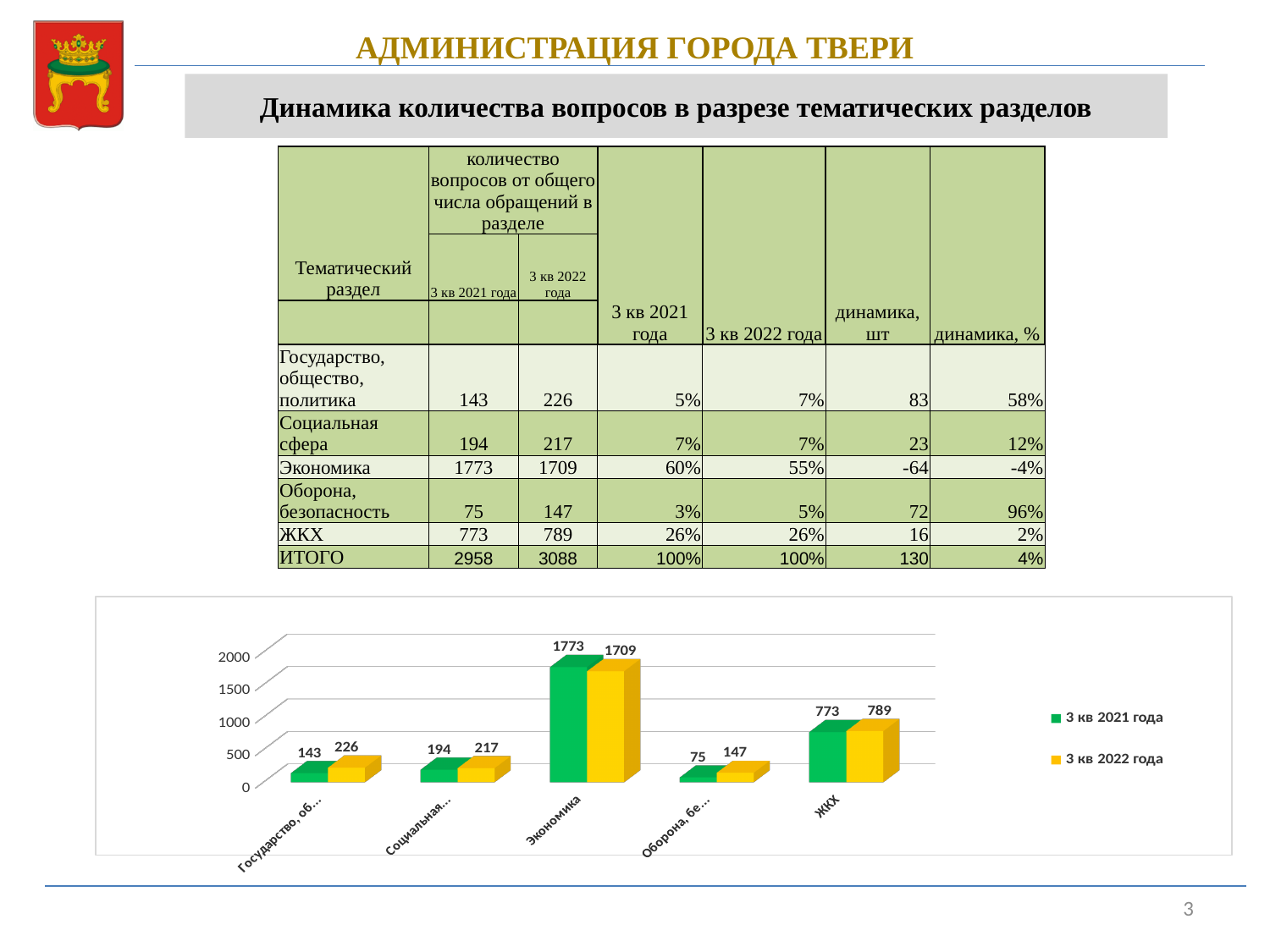
What is the value for Оборона, безопасность in the 3 кв 2021 года series? 75 For Экономика, which series has the larger value: 3 кв 2021 года or 3 кв 2022 года? 3 кв 2021 года How many series does the chart legend list? 2 Which category has the highest value in the 3 кв 2022 года series? Экономика How many categories are plotted on the chart's x axis? 5 What type of chart is shown on the slide? bar chart What is the value for ЖКХ in the 3 кв 2022 года series? 789 What is the value for Экономика in the 3 кв 2021 года series? 1773 Which category has the lowest value in the 3 кв 2021 года series? Оборона, безопасность What colour are the bars for the 3 кв 2022 года series? yellow Is the 3 кв 2022 года value for ЖКХ greater or less than 500? greater What is the difference between the 3 кв 2022 года and 3 кв 2021 года values for Государство, общество, политика? 83